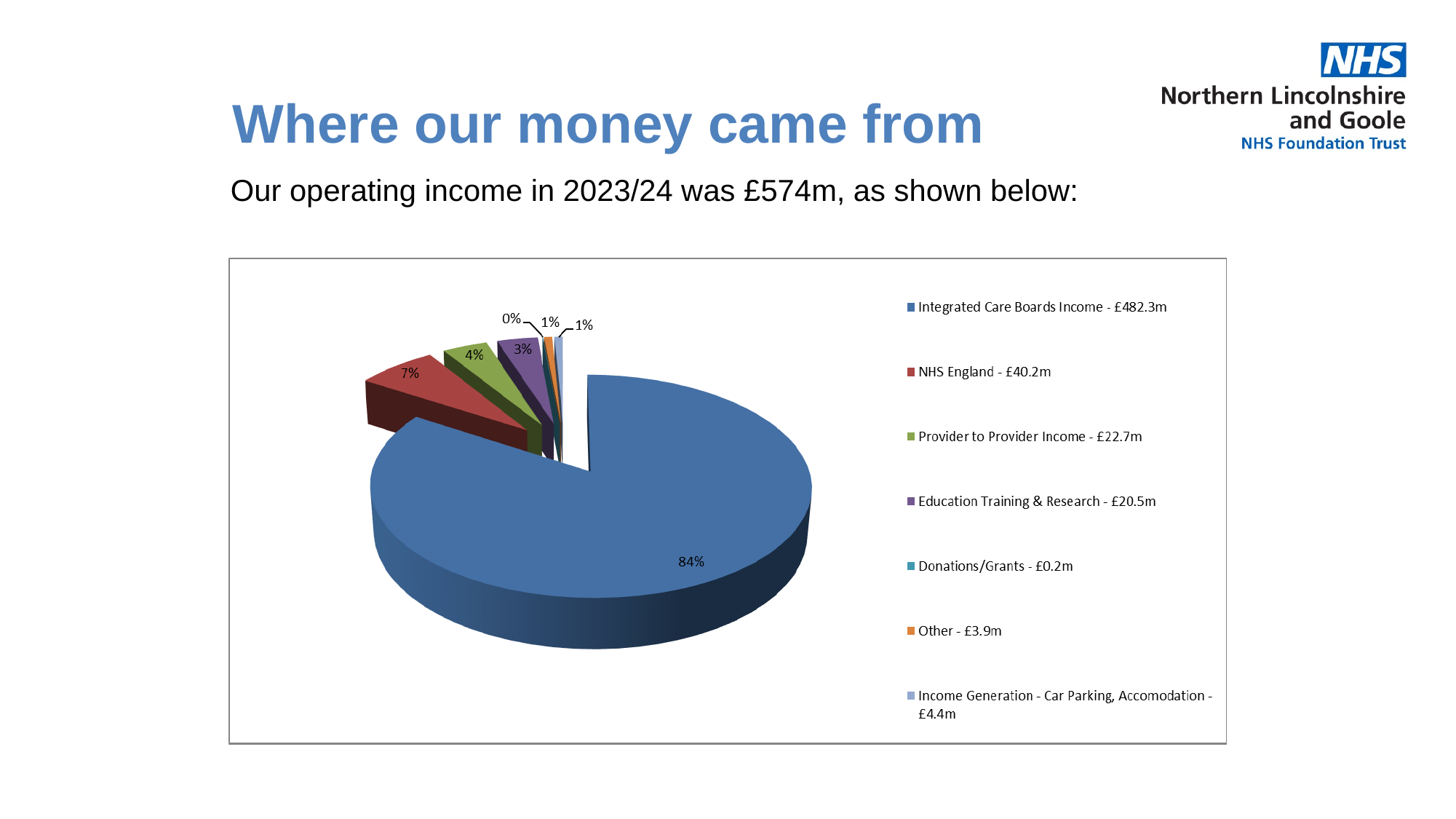
What is the income value shown in the legend for NHS England? £40.2m What is the income value shown in the legend for Donations/Grants? £0.2m Which category is the smallest slice of the pie? Donations/Grants What share of the pie does NHS England represent? 7% What share of the pie does Integrated Care Boards Income represent? 84% Which category is the largest slice of the pie? Integrated Care Boards Income What kind of chart is shown on the slide? Pie chart What share of the pie does Education Training & Research represent? 3% Which is larger, Provider to Provider Income or Education Training & Research? Provider to Provider Income How many categories does the pie chart's legend list? 7 What is the difference between the Integrated Care Boards Income value and the NHS England value shown in the legend? £442.1m